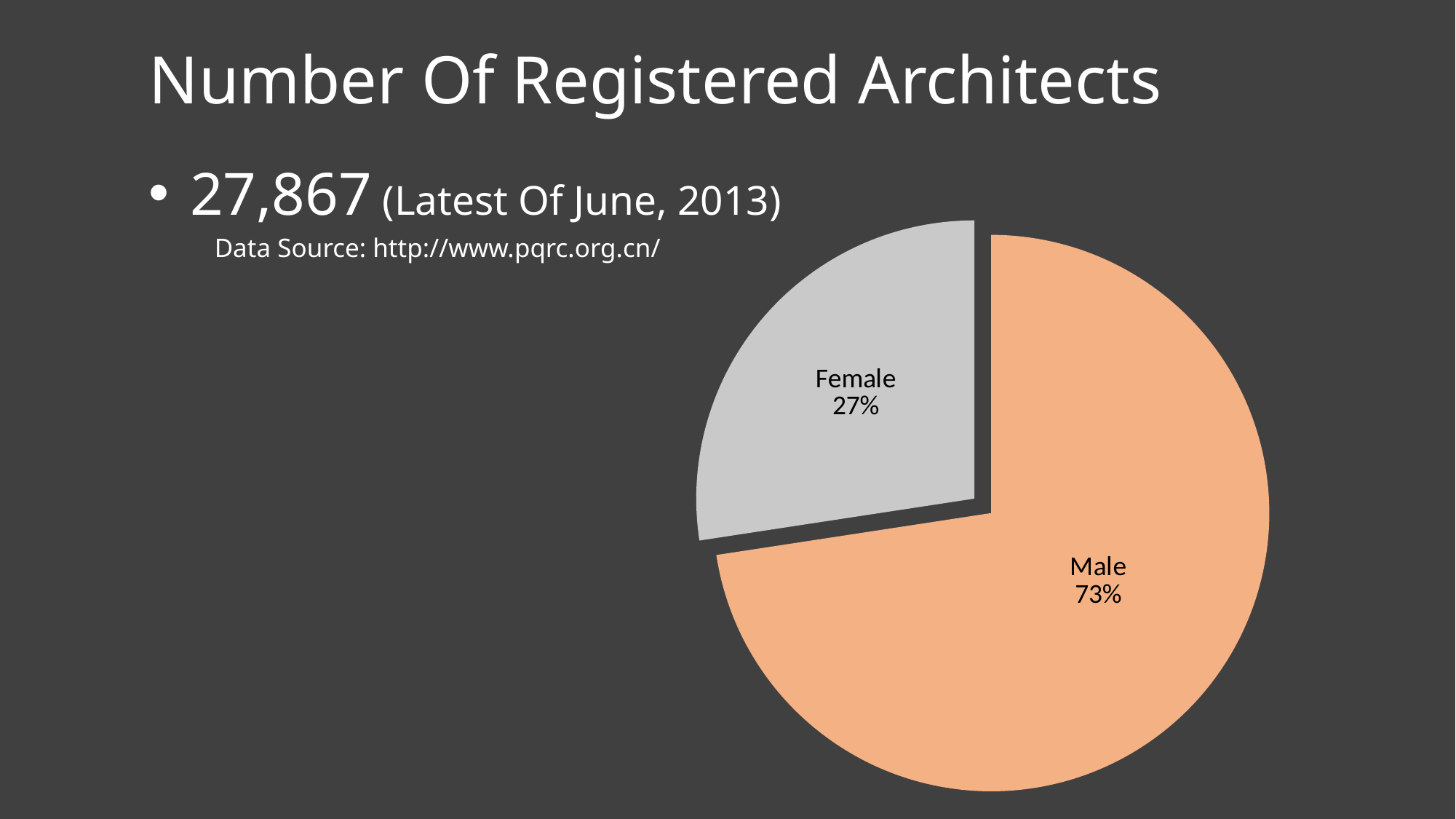
What colour is the Male slice of the pie? orange What colour is the Female slice of the pie? grey What is the difference in percentage points between the Male and Female slices? 46 Which slice of the pie is the smallest? Female Which is larger, the Male slice or the Female slice? Male What kind of chart is shown on the slide? pie chart How many slices does the pie chart have? 2 What share of the pie does the Male slice represent? 73% What share of the pie does the Female slice represent? 27% Which slice of the pie is the largest? Male